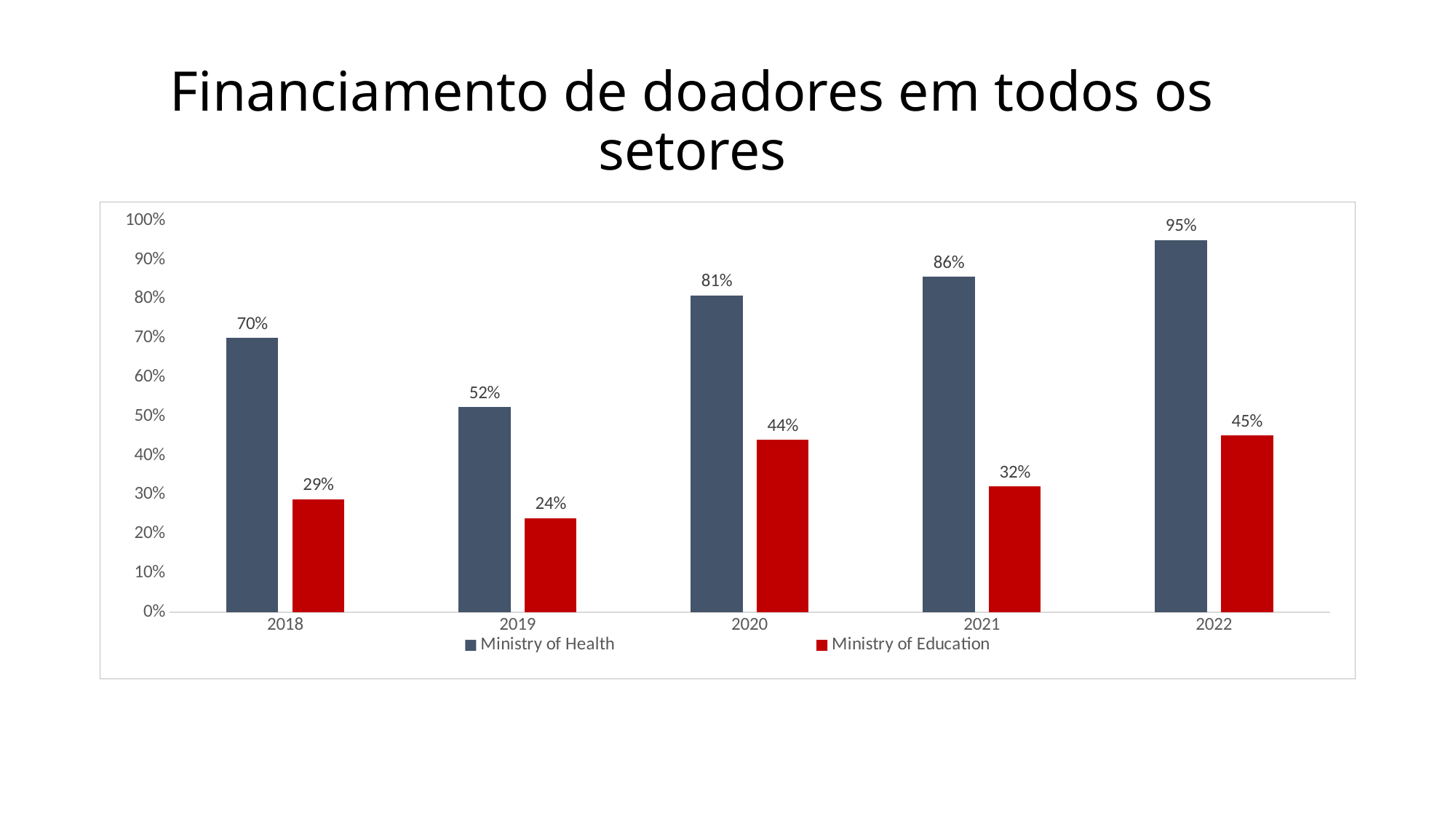
How many series does the legend list? 2 What is the value for Ministry of Education in 2019? 24% What kind of chart is shown on the slide? Bar chart In which year is the Ministry of Education value lowest? 2019 What is the difference between the Ministry of Health and Ministry of Education values in 2021? 54% What is the value for Ministry of Education in 2022? 45% What is the value for Ministry of Health in 2020? 81% Is the value for Ministry of Health in 2019 greater or less than 60%? less In which year is the Ministry of Health value highest? 2022 What colour are the Ministry of Education bars? Red How many years are shown on the x axis? 5 Which is larger: Ministry of Education in 2020 or Ministry of Education in 2021? Ministry of Education in 2020